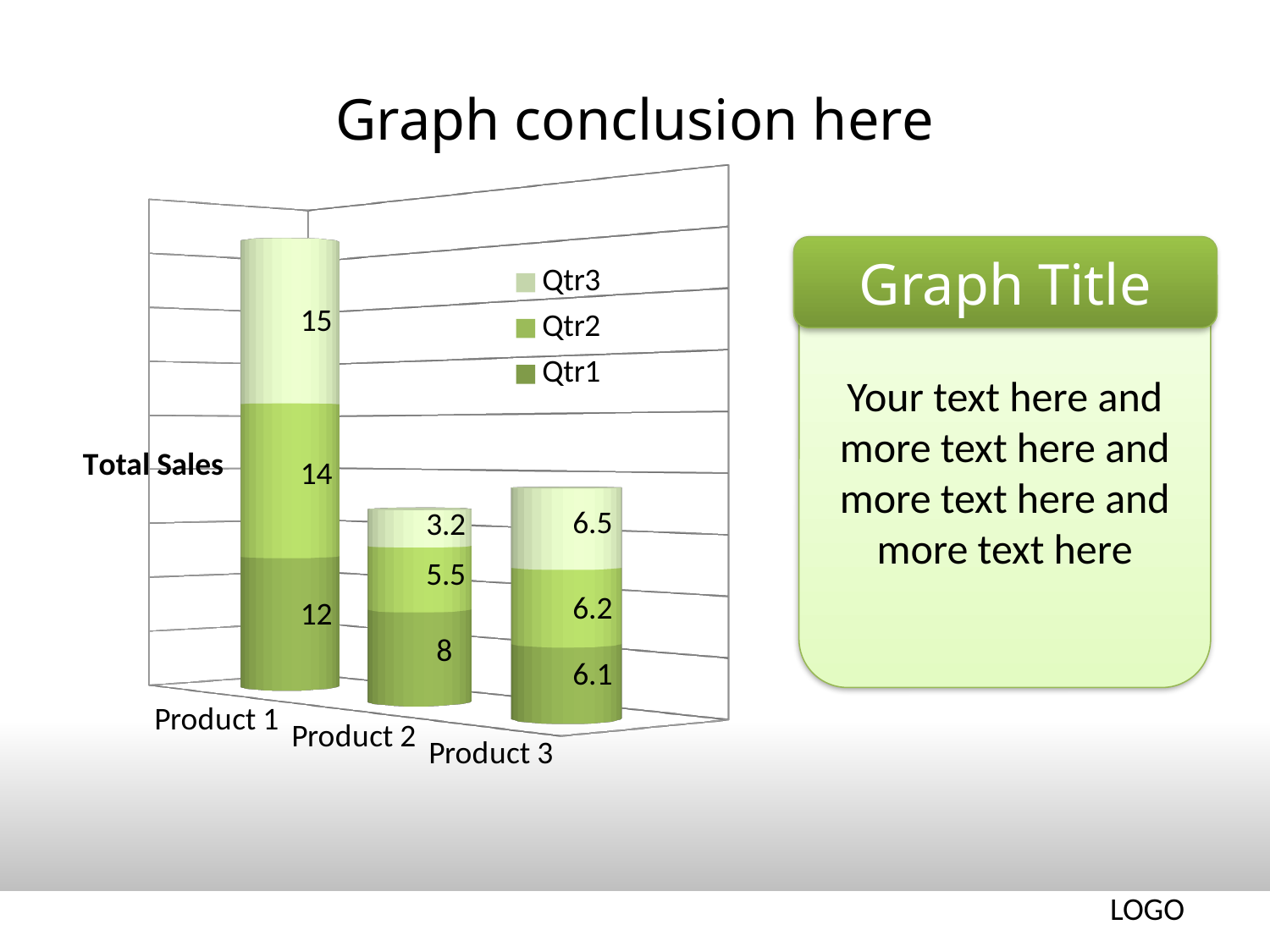
Which product has the lowest Qtr3 value? Product 2 What is the Qtr1 value for Product 1? 12 What is the total of the stacked bar for Product 1? 41 What is the label on the vertical axis of the chart? Total Sales Which product has the highest Qtr2 value? Product 1 Which is larger, the Qtr1 value for Product 2 or the Qtr1 value for Product 3? Product 2 What kind of chart is shown on the slide? Stacked bar chart What is the Qtr2 value for Product 3? 6.2 What is the difference between the Qtr1 values of Product 1 and Product 2? 4 How many series does the legend list? 3 What is the Qtr3 value for Product 2? 3.2 How many products are shown on the x axis? 3